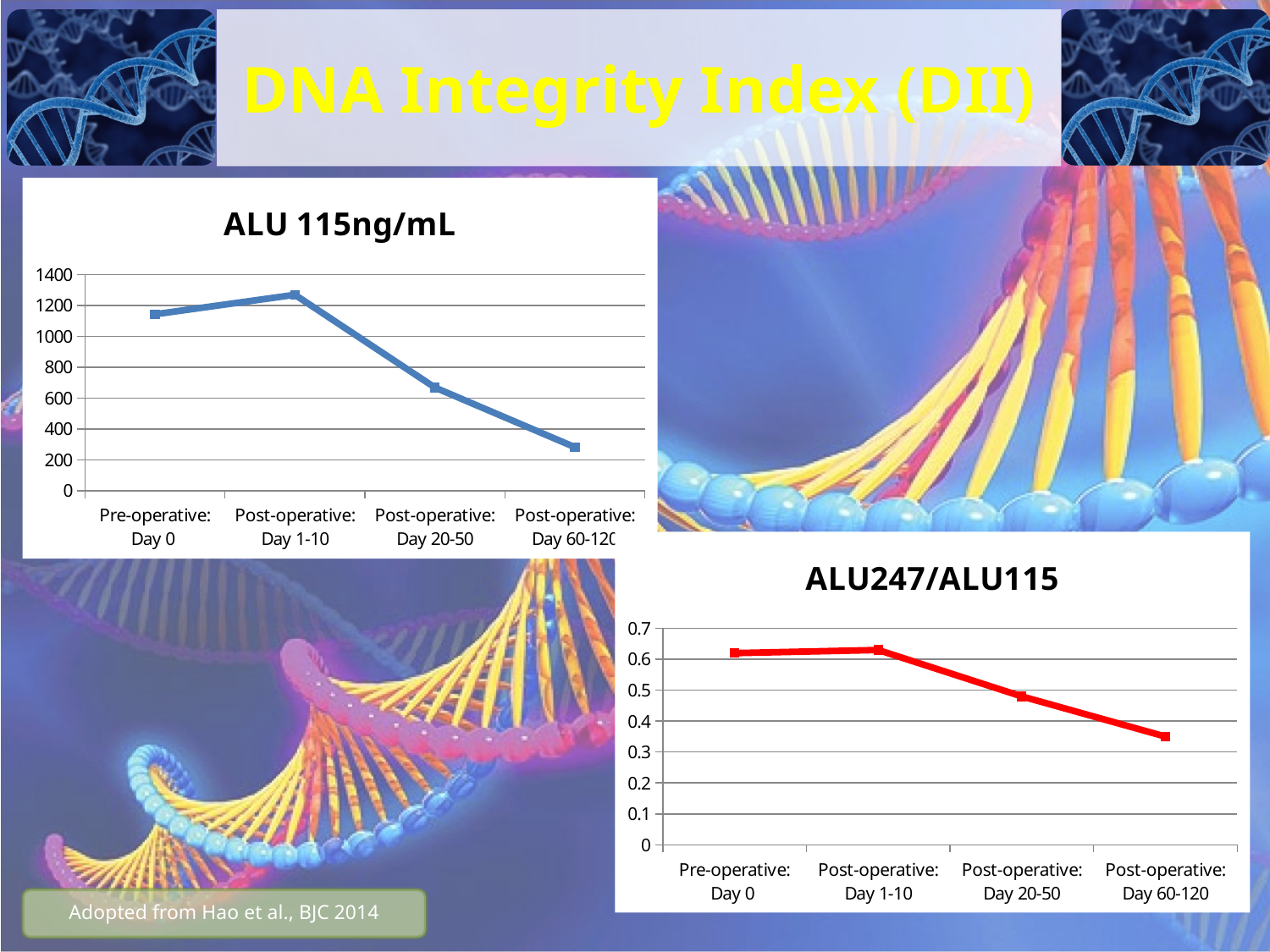
In the "ALU 115ng/mL" chart, is the value for Post-operative: Day 20-50 greater or less than 800? less What kind of chart is the "ALU 115ng/mL" chart? line chart In the "ALU 115ng/mL" chart, how many time points are plotted along the x axis? 4 In the "ALU 115ng/mL" chart, is the value for Pre-operative: Day 0 greater or less than 1000? greater In the "ALU 115ng/mL" chart, which time point has the lowest value? Post-operative: Day 60-120 In the "ALU247/ALU115" chart, which time point has the lowest value? Post-operative: Day 60-120 In the "ALU247/ALU115" chart, is the value for Pre-operative: Day 0 greater or less than 0.5? greater In the "ALU 115ng/mL" chart, which time point has the highest value? Post-operative: Day 1-10 What kind of chart is the "ALU247/ALU115" chart? line chart In the "ALU 115ng/mL" chart, which is larger: the value for Post-operative: Day 1-10 or Post-operative: Day 20-50? Post-operative: Day 1-10 In the "ALU247/ALU115" chart, how many categories are shown on the x axis? 4